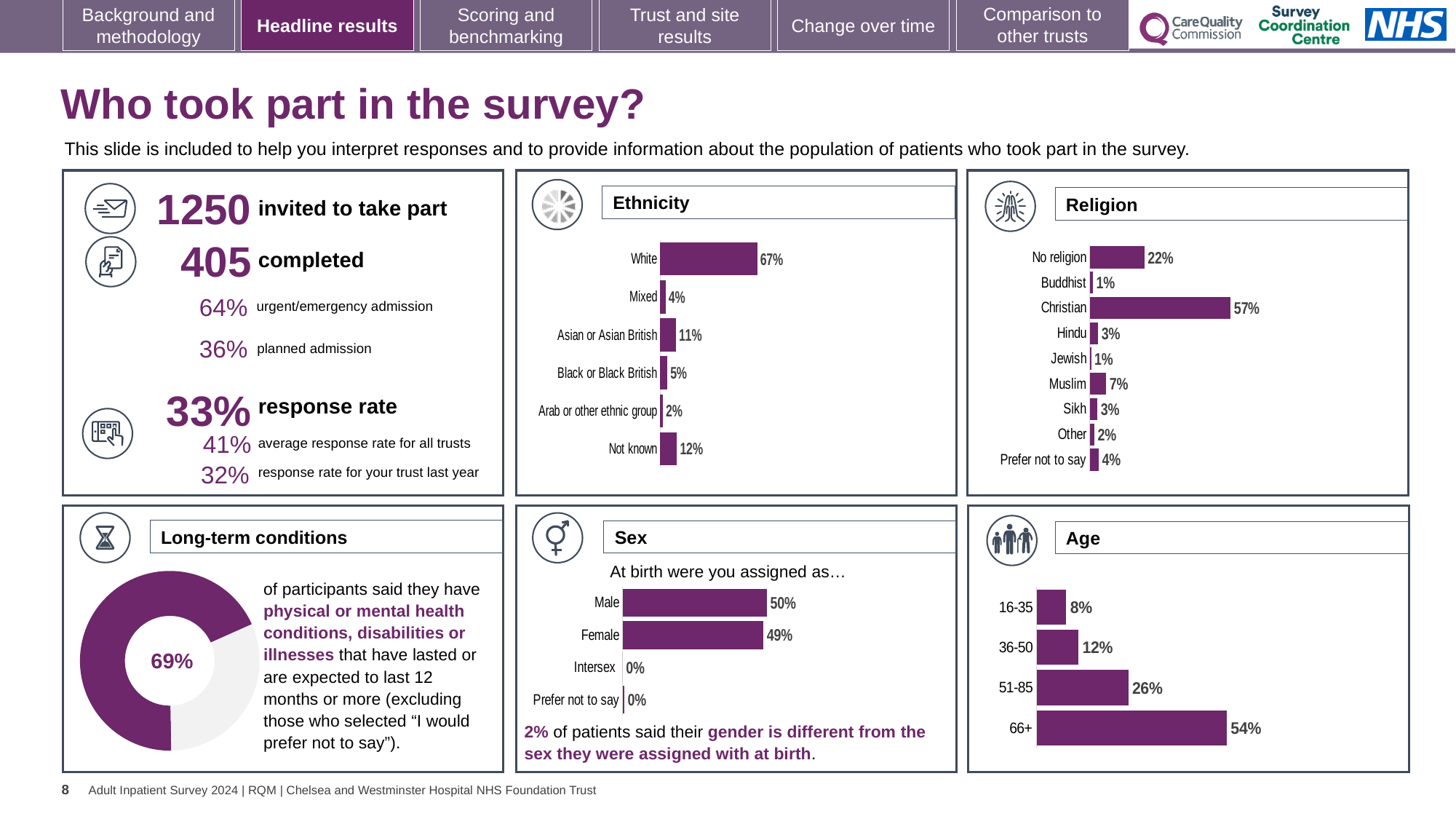
In the Sex chart, which is larger, Male or Female? Male In the Religion chart, what is the difference between Christian and No religion? 35% In the Age chart, what is the value for 51-85? 26% In the Ethnicity chart, what percentage of respondents were White? 67% In the Religion chart, what is the value for Muslim? 7% In the Long-term conditions chart, what share of participants said they have physical or mental health conditions, disabilities or illnesses? 69% In the Religion chart, how many categories are shown? 9 In the Sex chart, what is the value for Intersex? 0% In the Age chart, do the values rise or fall as age increases from 16-35 to 66+? rise In the Ethnicity chart, how many categories are shown? 6 In the Ethnicity chart, which category has the lowest value? Arab or other ethnic group In the Religion chart, which category has the highest value? Christian